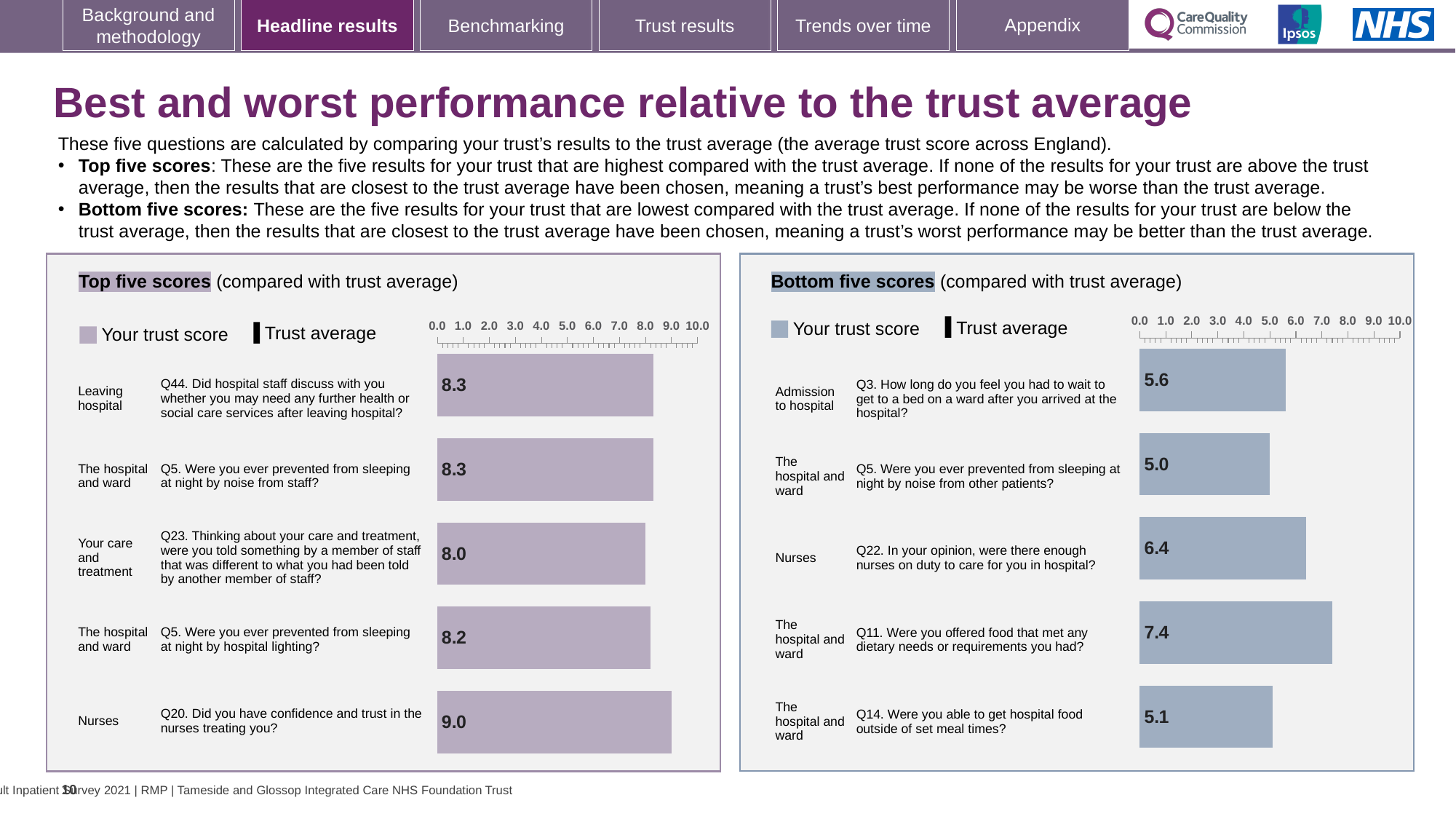
In the Bottom five scores chart, is the score for Q22 (enough nurses on duty) larger or smaller than the score for Q3 (wait for a bed)? larger In the Bottom five scores chart, which question has the lowest trust score? Q5. Were you ever prevented from sleeping at night by noise from other patients? In the Bottom five scores chart, which question has the highest trust score? Q11. Were you offered food that met any dietary needs or requirements you had? In the Top five scores chart, which question has the lowest trust score? Q23 (told something different by another member of staff) In the Bottom five scores chart, what is the trust score for Q14 about getting hospital food outside of set meal times? 5.1 In the Top five scores chart, what is the trust score for Q20 (confidence and trust in the nurses treating you)? 9.0 In the Top five scores chart, what is the trust score for Q44 about discussing further health or social care services after leaving hospital? 8.3 In the Top five scores chart, which question has the highest trust score? Q20. Did you have confidence and trust in the nurses treating you? In the Top five scores chart, what is the difference between the score for Q20 and the score for Q23? 1.0 How many questions are plotted in the Bottom five scores chart? 5 In the Bottom five scores chart, what is the trust score for Q3 about waiting to get to a bed on a ward? 5.6 What kind of chart is used in the Top five scores panel? bar chart